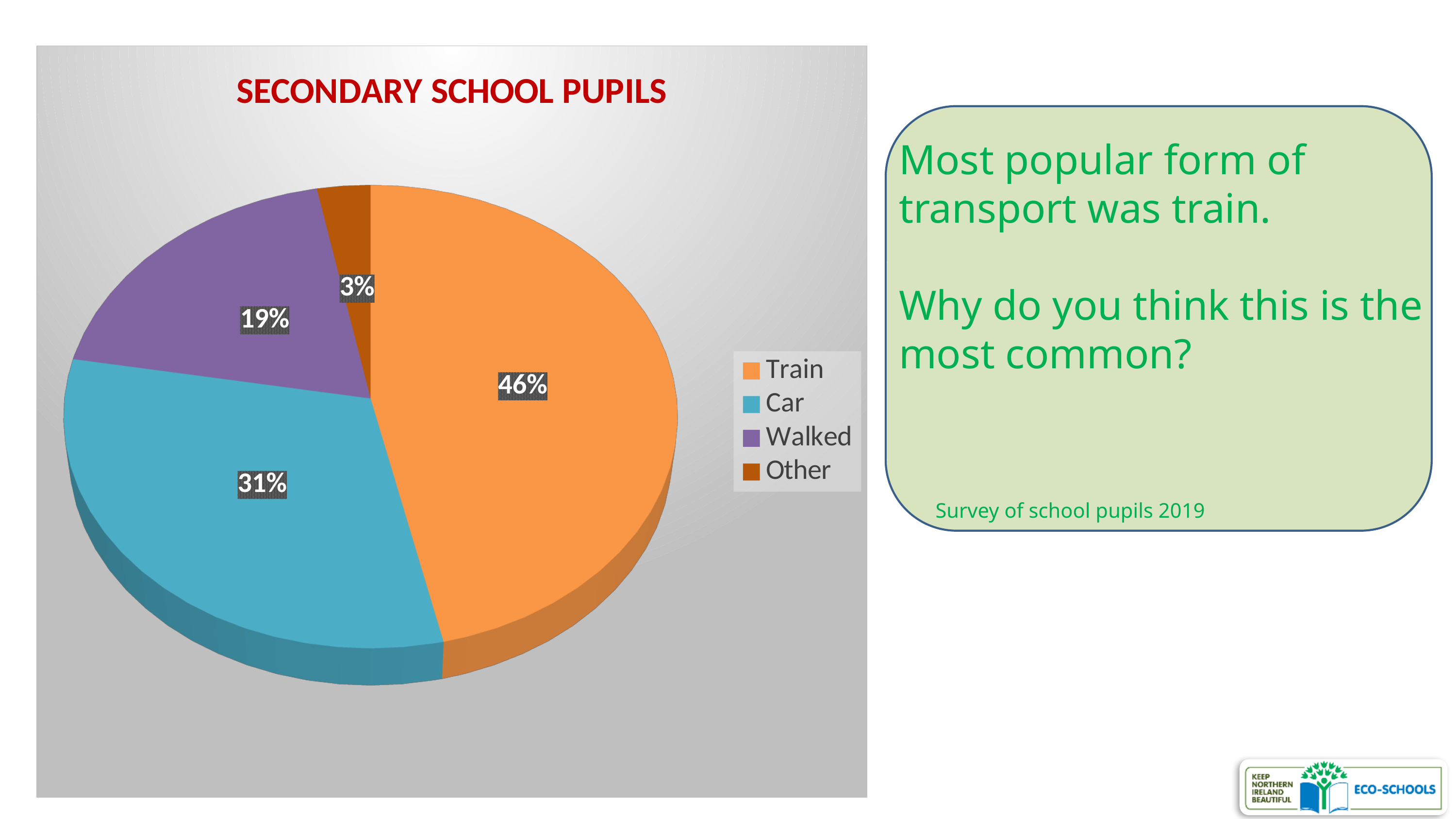
What percentage of secondary school pupils walked? 19% What is the title of the chart? SECONDARY SCHOOL PUPILS Which is larger, the share for Car or the share for Walked? Car What percentage of secondary school pupils travelled by car? 31% Which form of transport has the largest share of the pie? Train What kind of chart is shown on the slide? Pie chart What is the difference in percentage points between the Train and Car slices? 15 What colour is the Walked slice in the pie chart? Purple What percentage of secondary school pupils used 'Other' forms of transport? 3% What percentage of secondary school pupils travelled by train? 46% Which form of transport has the smallest share of the pie? Other How many categories are shown in the pie chart? 4